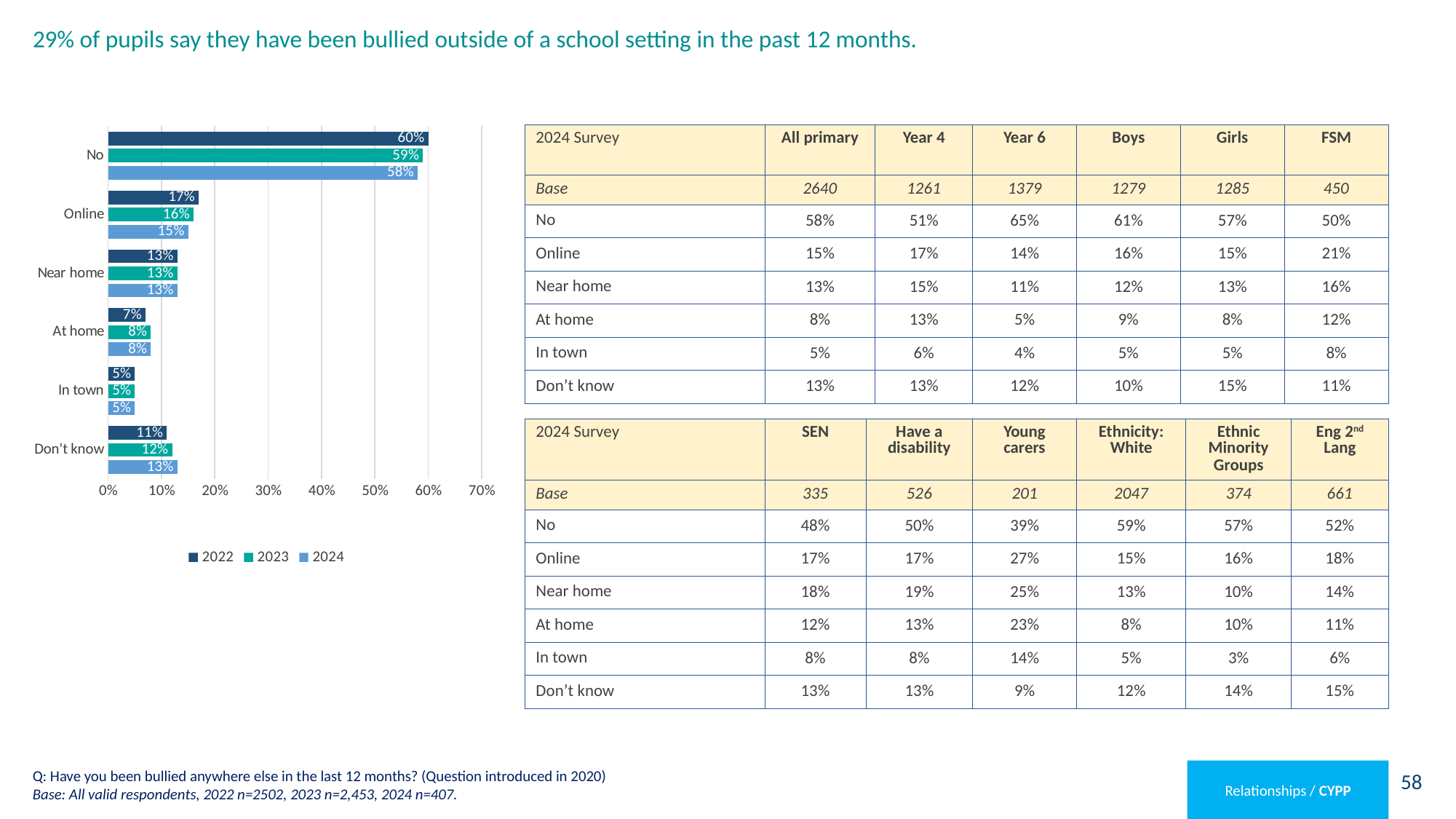
What is the value for 'Don't know' in the 2023 series? 12% Which series does the legend list first? 2022 How many categories are shown on the chart? 6 What is the value for 'No' in the 2022 series? 60% What kind of chart is shown on the slide? Bar chart How many series does the legend list? 3 What is the value for 'Online' in the 2024 series? 15% Which category has the highest value in the 2024 series? No Which is larger: the 2022 value for 'Online' or the 2022 value for 'Near home'? Online Which category has the lowest value in the 2022 series? In town What is the difference between the 2022 and 2024 values for 'No'? 2% Does the value for 'No' rise or fall from 2022 to 2024? Fall